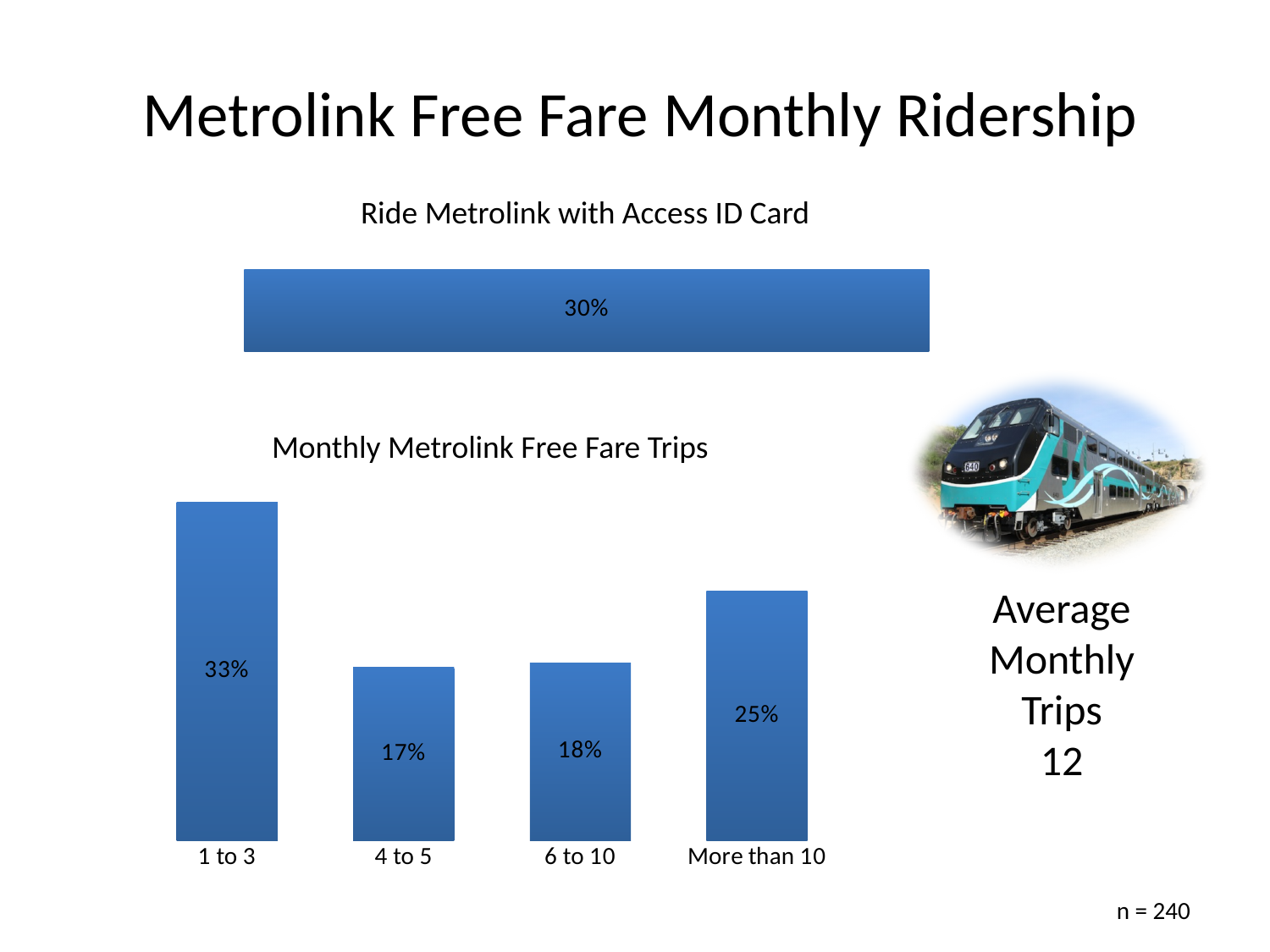
In the 'Monthly Metrolink Free Fare Trips' chart, which is larger: the value for '6 to 10' or the value for 'More than 10'? More than 10 In the 'Monthly Metrolink Free Fare Trips' chart, which category has the lowest value? 4 to 5 In the 'Monthly Metrolink Free Fare Trips' chart, what is the difference between the values for '1 to 3' and 'More than 10'? 8% What kind of chart is the 'Ride Metrolink with Access ID Card' chart? Bar chart What is the title of the lower chart on the slide? Monthly Metrolink Free Fare Trips In the 'Monthly Metrolink Free Fare Trips' chart, which category has the highest value? 1 to 3 How many categories are shown in the 'Monthly Metrolink Free Fare Trips' chart? 4 What kind of chart is the 'Monthly Metrolink Free Fare Trips' chart? Bar chart In the 'Ride Metrolink with Access ID Card' chart, what value is shown on the bar? 30% In the 'Monthly Metrolink Free Fare Trips' chart, what is the value for '4 to 5'? 17% In the 'Monthly Metrolink Free Fare Trips' chart, what is the value for '1 to 3'? 33% In the 'Monthly Metrolink Free Fare Trips' chart, what is the value for 'More than 10'? 25%